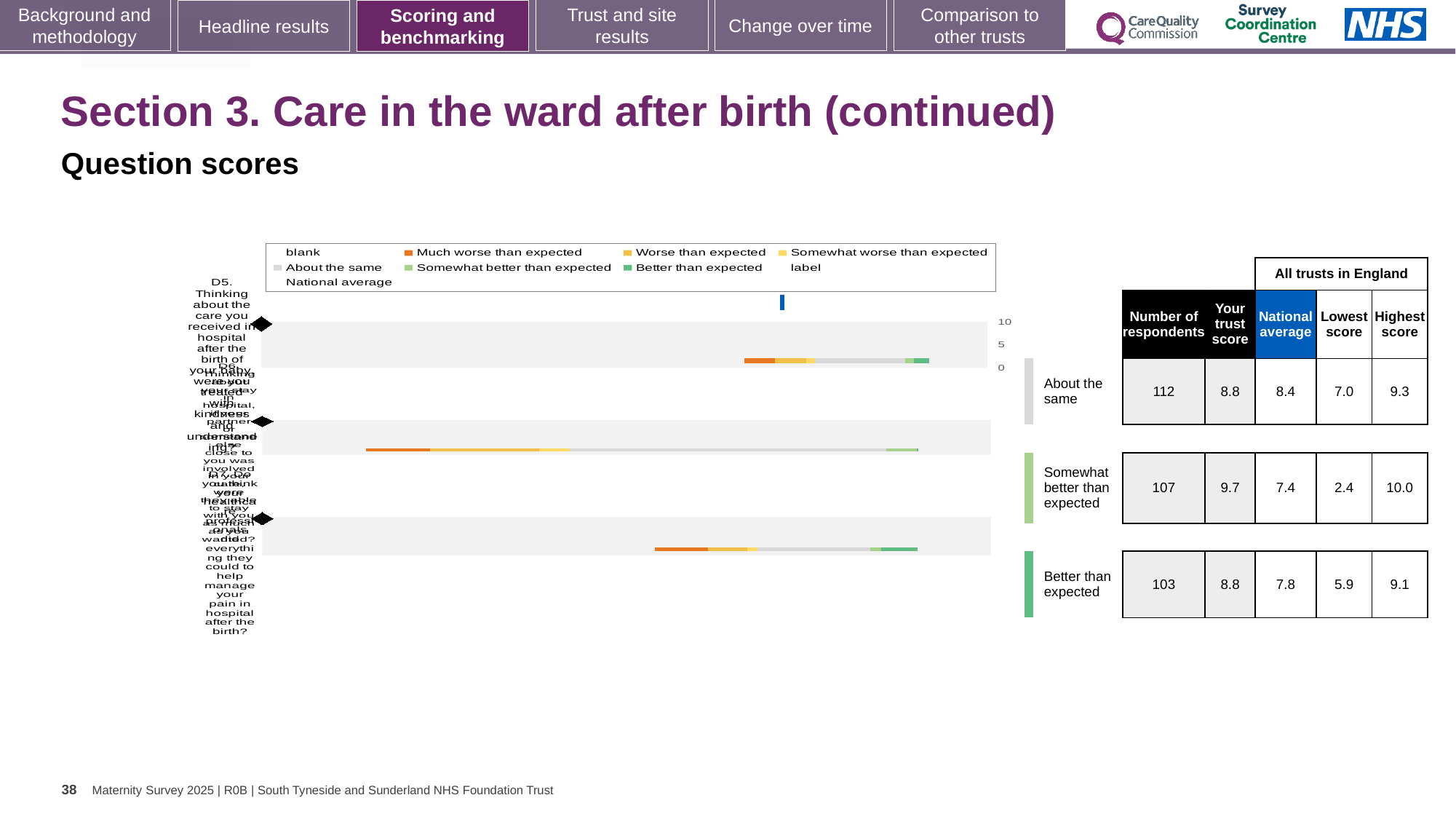
In the table beside the chart, which row has the lowest number of respondents? Better than expected In the table beside the chart, what is the trust score for the row labelled 'Somewhat better than expected'? 9.7 How many question rows (bars) are plotted in the chart? 3 What kind of chart is shown on the slide? Bar chart In the table beside the chart, which row has the highest trust score? Somewhat better than expected In the table beside the chart, what is the lowest score for the row labelled 'About the same'? 7.0 In the table beside the chart, what is the difference between the trust score and the national average for the row labelled 'Somewhat better than expected'? 2.3 In the table beside the chart, what is the national average for the row labelled 'Better than expected'? 7.8 In the table beside the chart, what is the highest score for the row labelled 'Somewhat better than expected'? 10.0 In the chart legend, what colour represents 'Much worse than expected'? Orange In the table beside the chart, what is the number of respondents for the row labelled 'About the same'? 112 What is the highest tick value shown on the chart's numeric axis? 10